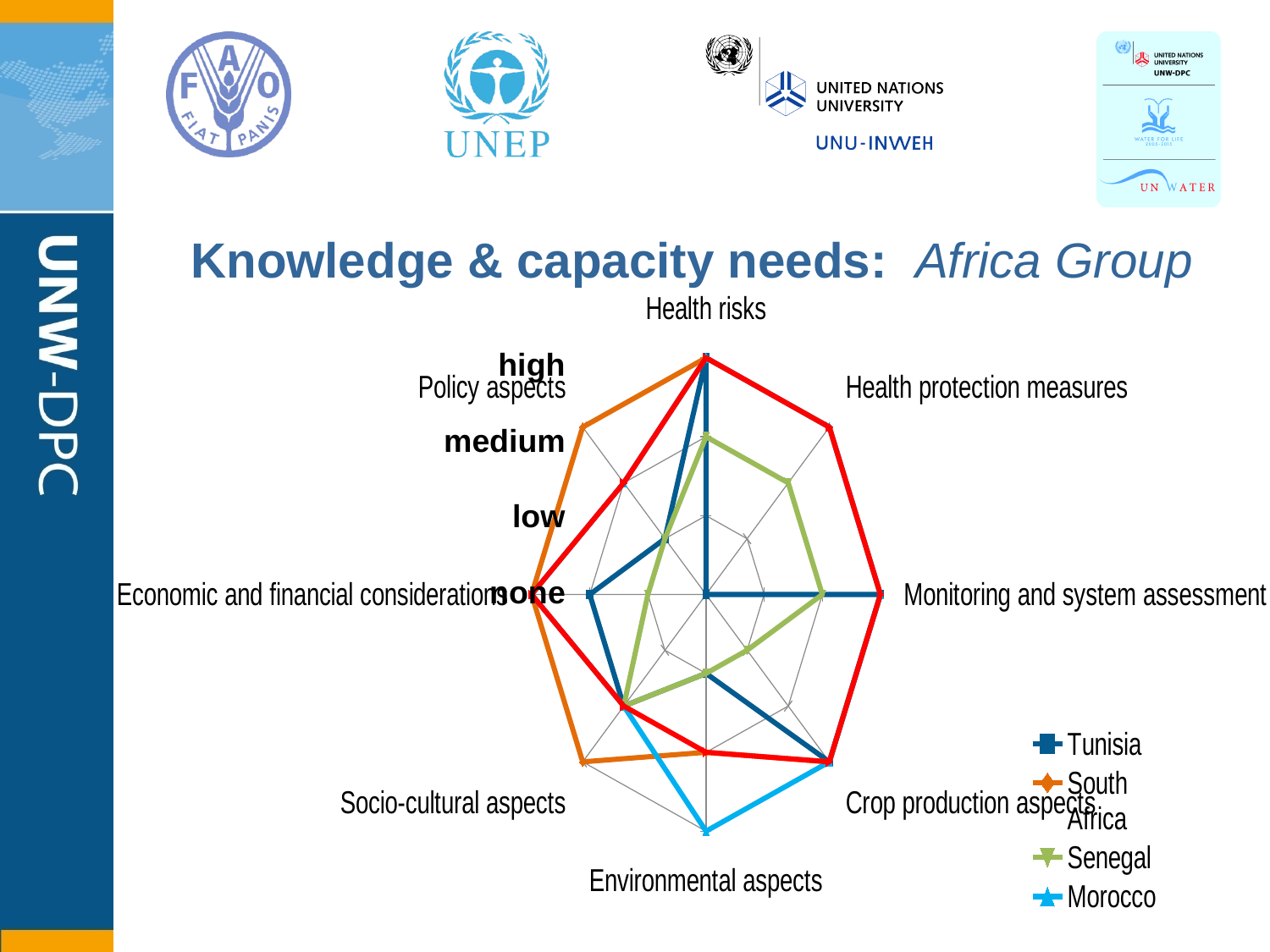
What is the level for Tunisia on Monitoring and system assessment? high What is the level for Morocco on Environmental aspects? high Which is higher on Environmental aspects, Morocco or Tunisia? Morocco What is the level for South Africa on Policy aspects? high What kind of chart is shown on the slide? Radar chart What is the level for Tunisia on Health risks? high Which is higher on Health risks, Tunisia or Senegal? Tunisia How many categories (axes) does the radar chart have? 8 What is the level for Senegal on Health risks? medium How many series does the legend list? 4 What is the title of the chart on the slide? Knowledge & capacity needs: Africa Group What is the level for Tunisia on Environmental aspects? low